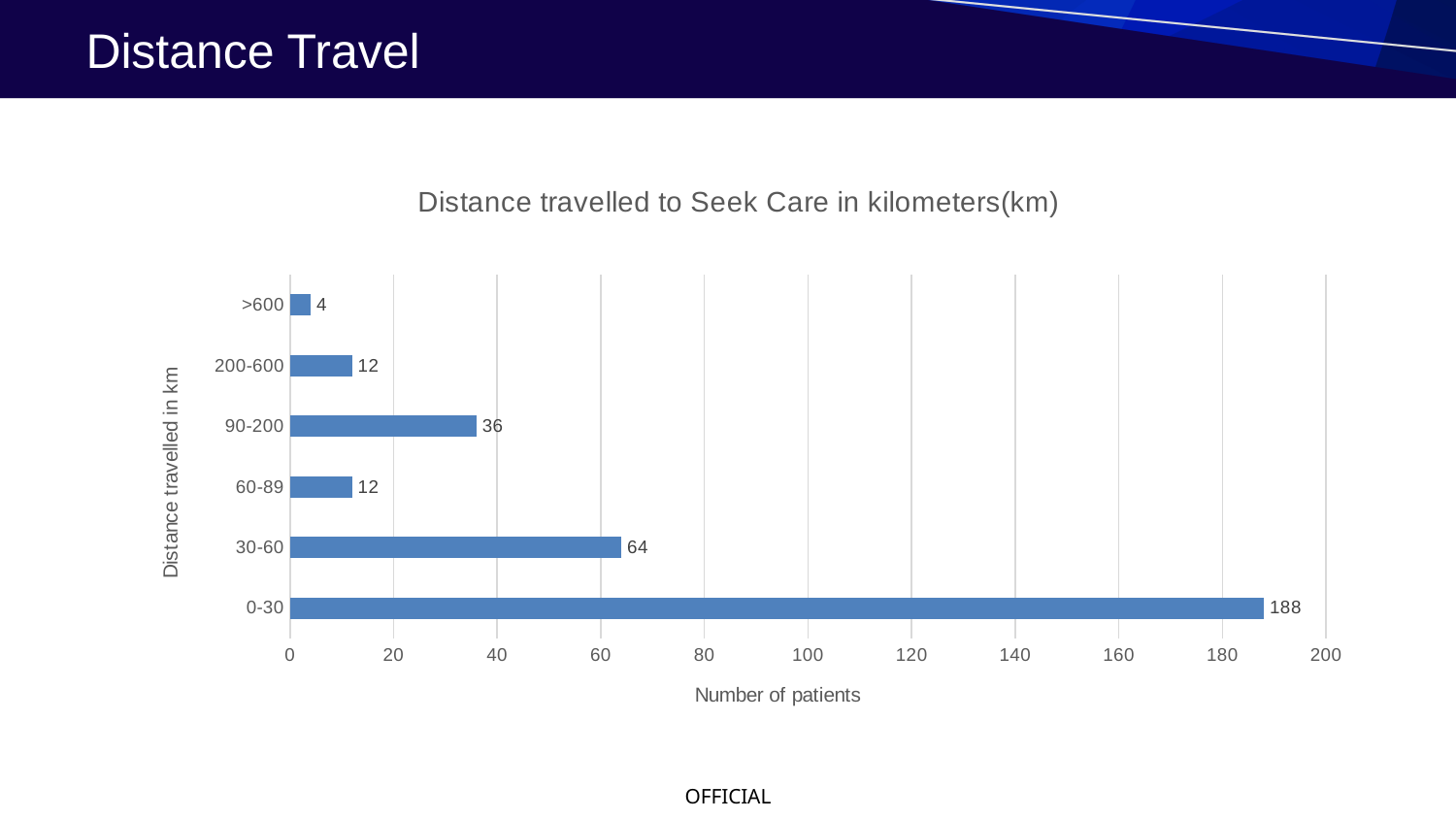
What is the difference in number of patients between the 0-30 km and 30-60 km categories? 124 How many patients travelled more than 600 km? 4 Is the number of patients for the 30-60 km category greater or less than 80? less What is the difference in number of patients between the 90-200 km and 200-600 km categories? 24 What type of chart is shown on the slide? bar chart How many distance categories are shown in the chart? 6 Which distance category has the lowest number of patients? >600 How many patients travelled 0-30 km to seek care? 188 Which distance category has the highest number of patients? 0-30 What is the number of patients for the 30-60 km category? 64 What is the title of the chart? Distance travelled to Seek Care in kilometers(km) Which has more patients, the 90-200 km category or the 60-89 km category? 90-200